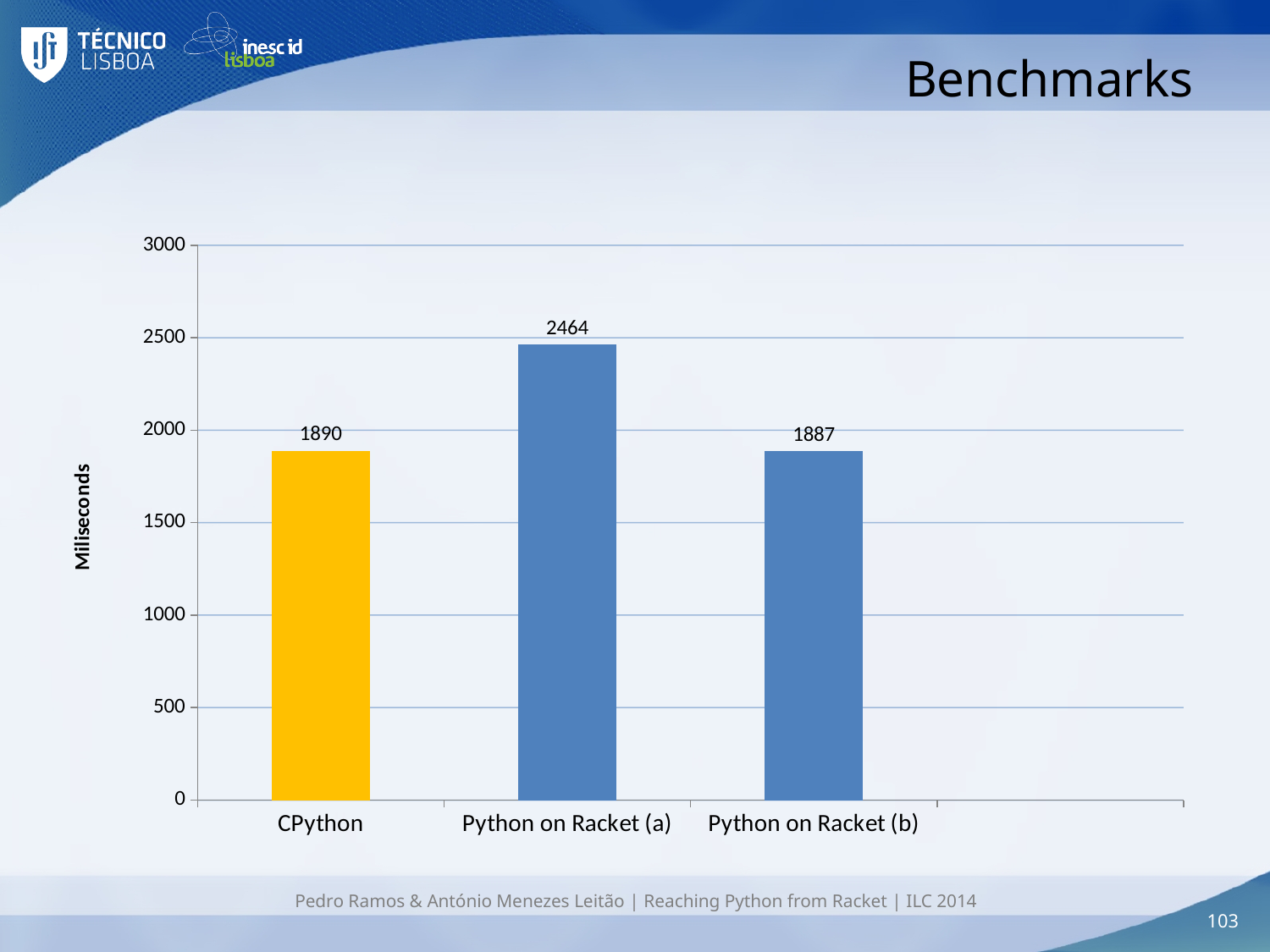
Which category has the highest value? Python on Racket (a) What is the label of the vertical axis? Miliseconds How many categories are shown on the x axis? 3 What is the value for Python on Racket (b)? 1887 What is the value for Python on Racket (a)? 2464 What kind of chart is shown on the slide? bar chart What is the difference between the values for Python on Racket (a) and CPython? 574 Is the value for Python on Racket (a) greater or less than 2000? greater What is the difference between the values for CPython and Python on Racket (b)? 3 What is the value for CPython? 1890 Is the value for CPython greater or less than 2000? less Which is larger, the value for Python on Racket (a) or the value for Python on Racket (b)? Python on Racket (a)